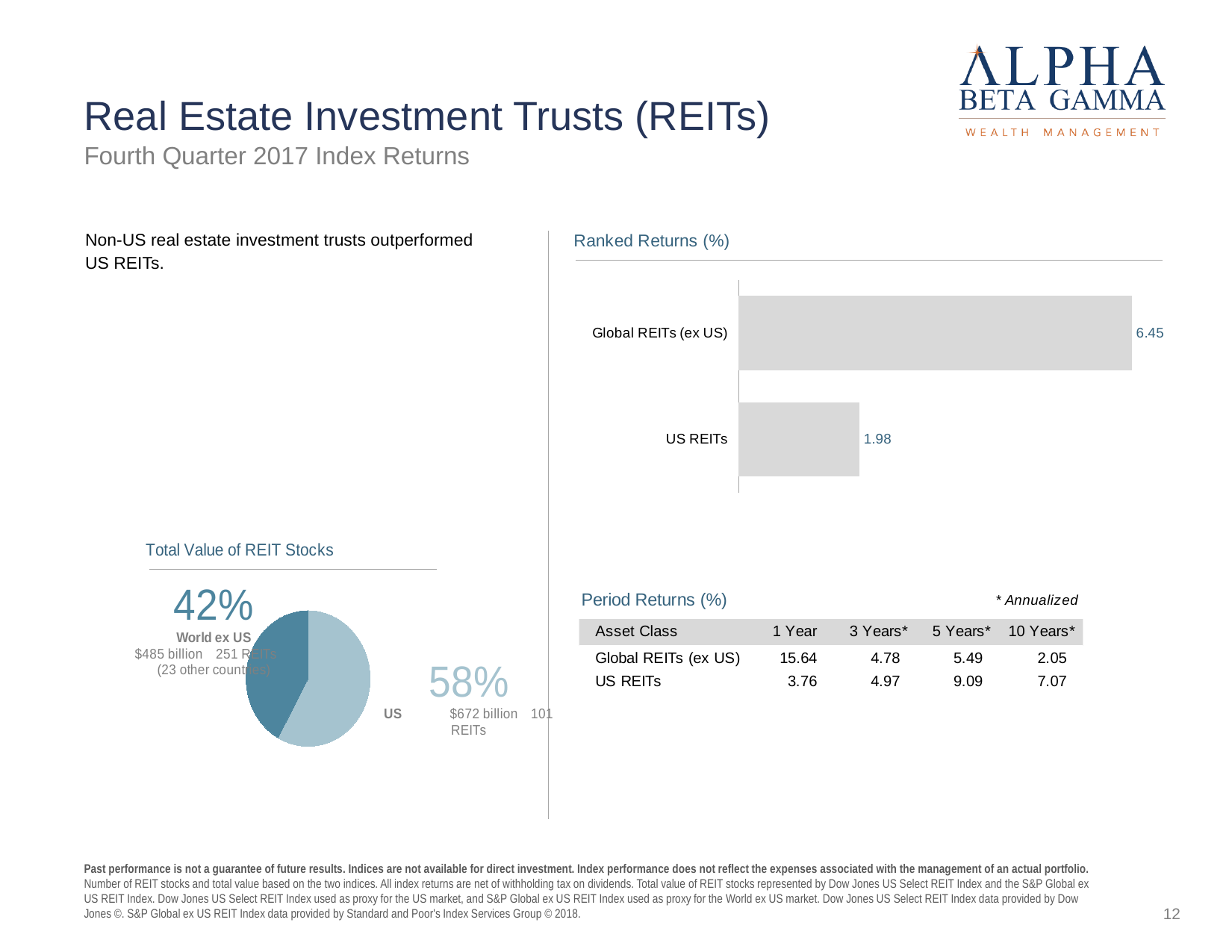
How many categories are shown in the Ranked Returns (%) chart? 2 What kind of chart is the Total Value of REIT Stocks chart? Pie chart In the Total Value of REIT Stocks pie chart, which slice is larger: US or World ex US? US In the Total Value of REIT Stocks pie chart, what share does the US slice represent? 58% In the Ranked Returns (%) chart, which category has the highest value? Global REITs (ex US) In the Ranked Returns (%) chart, what is the value for US REITs? 1.98 In the Total Value of REIT Stocks pie chart, what share does the World ex US slice represent? 42% In the Ranked Returns (%) chart, what is the difference between the values for Global REITs (ex US) and US REITs? 4.47 What kind of chart is the Ranked Returns (%) chart? Bar chart In the Ranked Returns (%) chart, which is larger: the value for Global REITs (ex US) or the value for US REITs? Global REITs (ex US) In the Ranked Returns (%) chart, which category has the lowest value? US REITs In the Ranked Returns (%) chart, what is the value for Global REITs (ex US)? 6.45